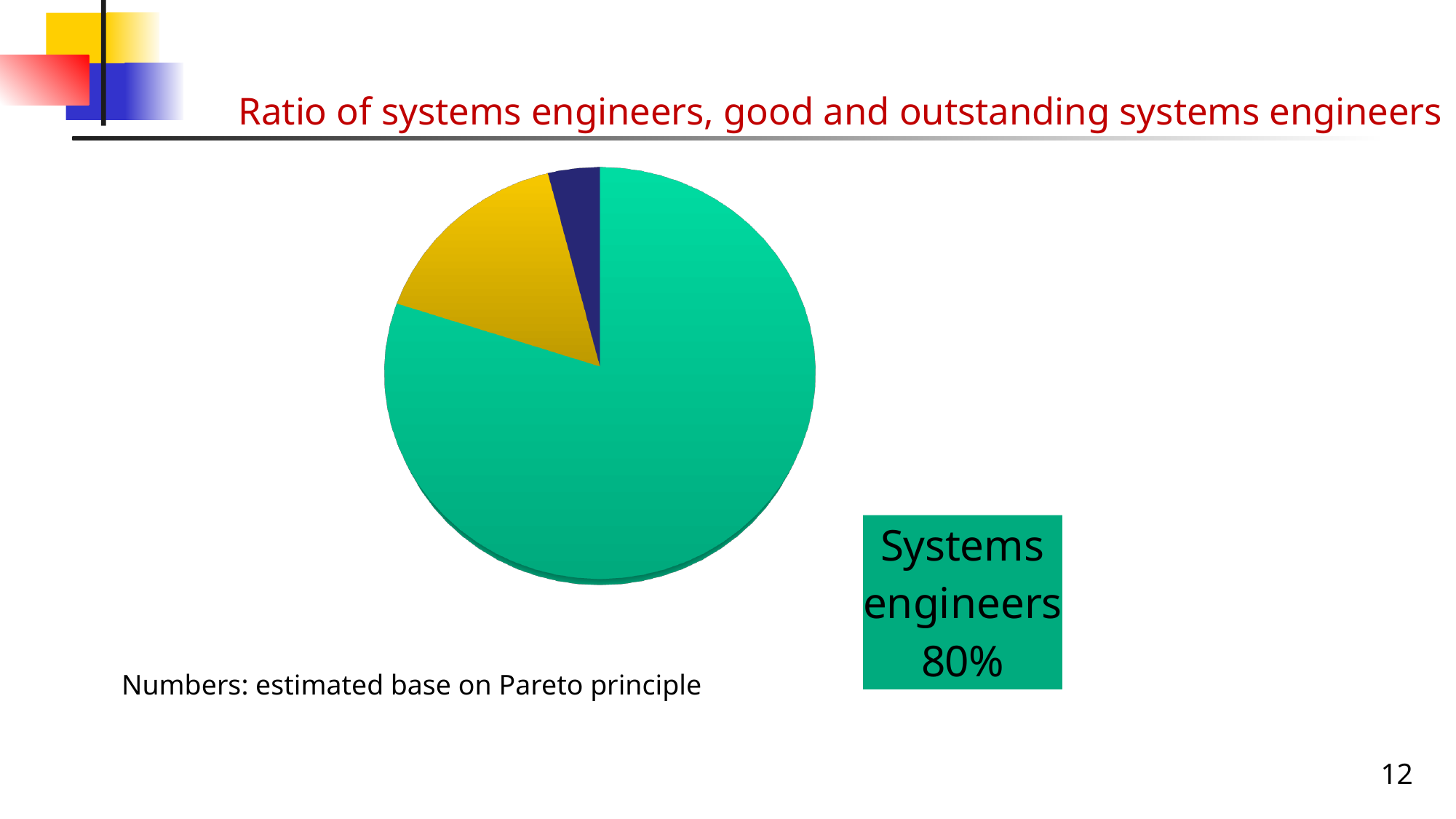
What share of the pie is labelled for Systems engineers? 80% What is the title of the slide containing the pie chart? Ratio of systems engineers, good and outstanding systems engineers Which slice is larger, the yellow slice or the dark blue slice? yellow What kind of chart is shown on the slide? pie chart Which slice of the pie chart is the largest? Systems engineers What colour is the Systems engineers slice in the pie chart? green Is the share for Systems engineers greater or less than 50%? greater How many slices does the pie chart have? 3 Which colour slice of the pie chart is the smallest? dark blue